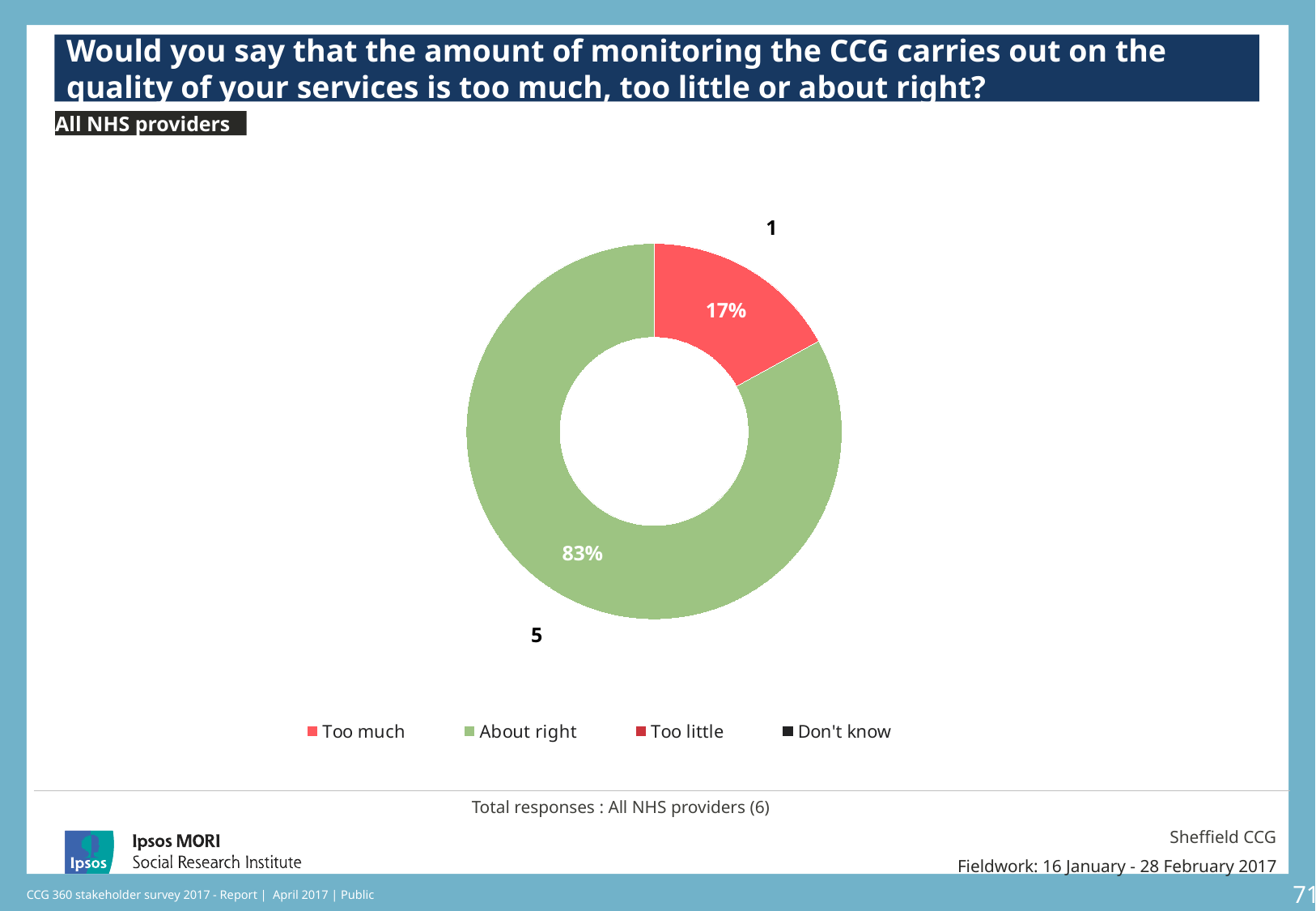
Which is larger, the share for "About right" or the share for "Too much"? About right Which response category has the largest share of the chart? About right How many respondents answered "About right"? 5 What is the difference in percentage points between "About right" and "Too much"? 66 What percentage of respondents said the amount of monitoring is "Too much"? 17% How many response categories does the legend list? 4 Which of the two plotted response categories has the smallest share? Too much How many respondents answered "Too much"? 1 What kind of chart is shown on the slide? Pie (donut) chart What is the total number of responses shown for All NHS providers? 6 What colour is the "About right" slice of the chart? Green What percentage of respondents said the amount of monitoring is "About right"? 83%